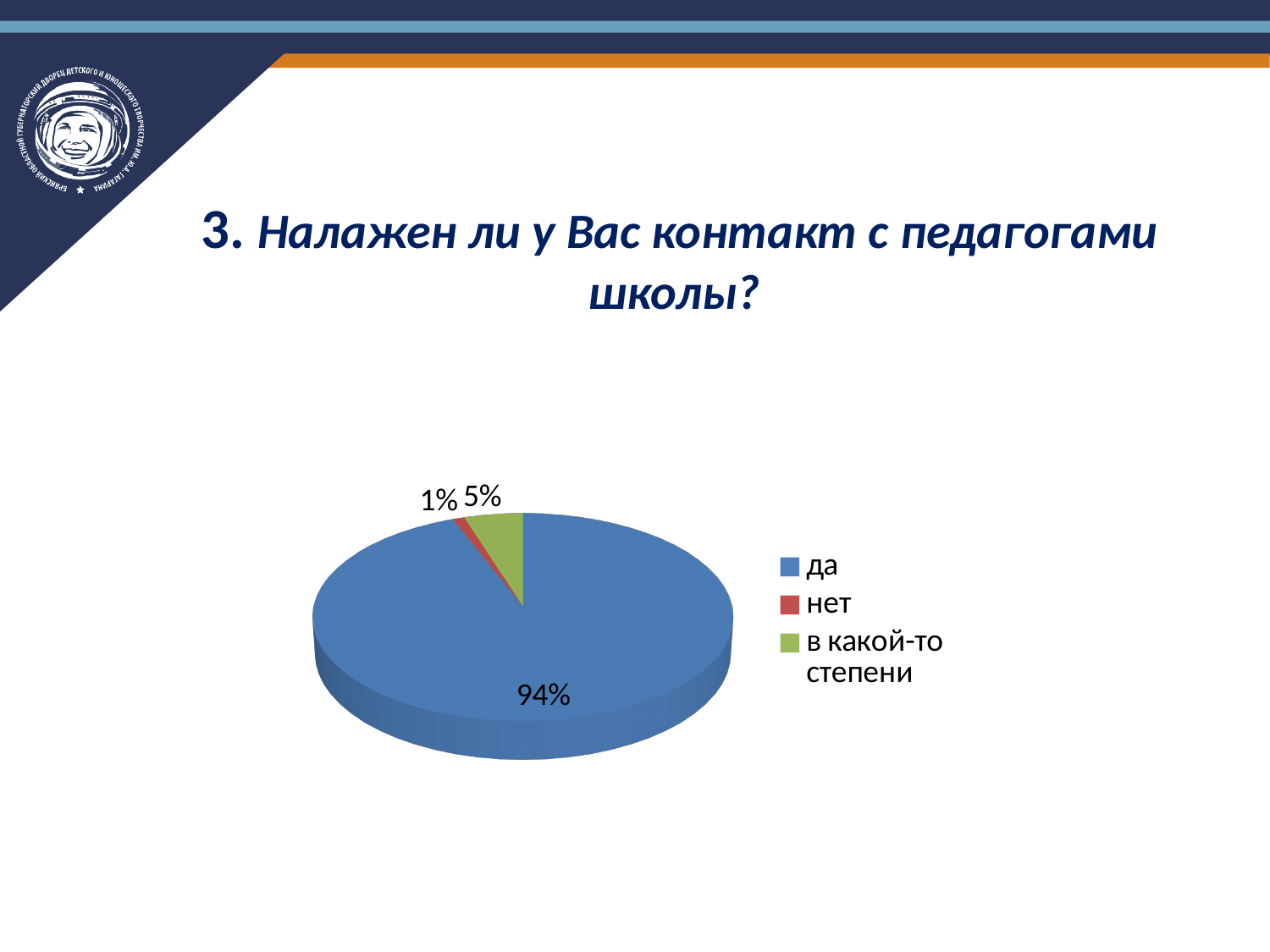
How many slices does the pie chart have? 3 How many categories does the legend list? 3 What kind of chart is shown on the slide? pie chart Which category has the largest slice of the pie? да What share of the pie does "нет" take? 1% What is the title of the slide above the chart? 3. Налажен ли у Вас контакт с педагогами школы? What share of the pie does "в какой-то степени" take? 5% What colour is the slice for "да"? blue Which is larger, the slice for "нет" or the slice for "в какой-то степени"? в какой-то степени What is the difference in percentage points between "да" and "в какой-то степени"? 89 Which category has the smallest slice of the pie? нет What share of the pie does "да" take? 94%